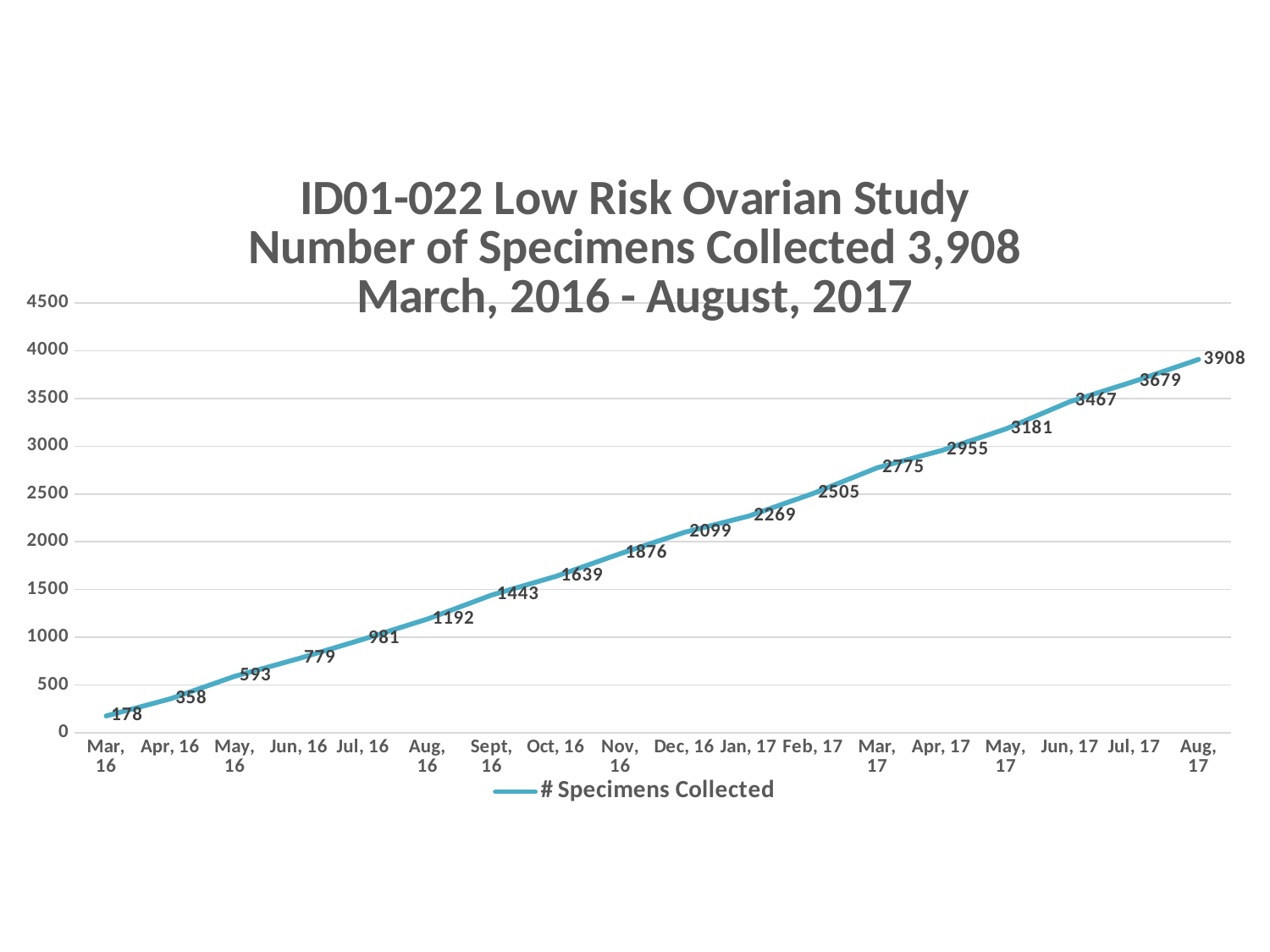
Do the values rise or fall from Mar, 16 to Aug, 17? rise What kind of chart is shown? line chart What is the value for Mar, 16? 178 How many months are plotted on the x axis? 18 What is the difference between the values for Apr, 17 and Mar, 17? 180 Is the value for Nov, 16 greater or less than 2000? less Which month has the highest number of specimens collected? Aug, 17 Which is larger, the value for Jul, 16 or the value for Sept, 16? Sept, 16 Which month has the lowest number of specimens collected? Mar, 16 What is the value for Aug, 17? 3908 How many series does the legend list? 1 What is the value for Dec, 16? 2099